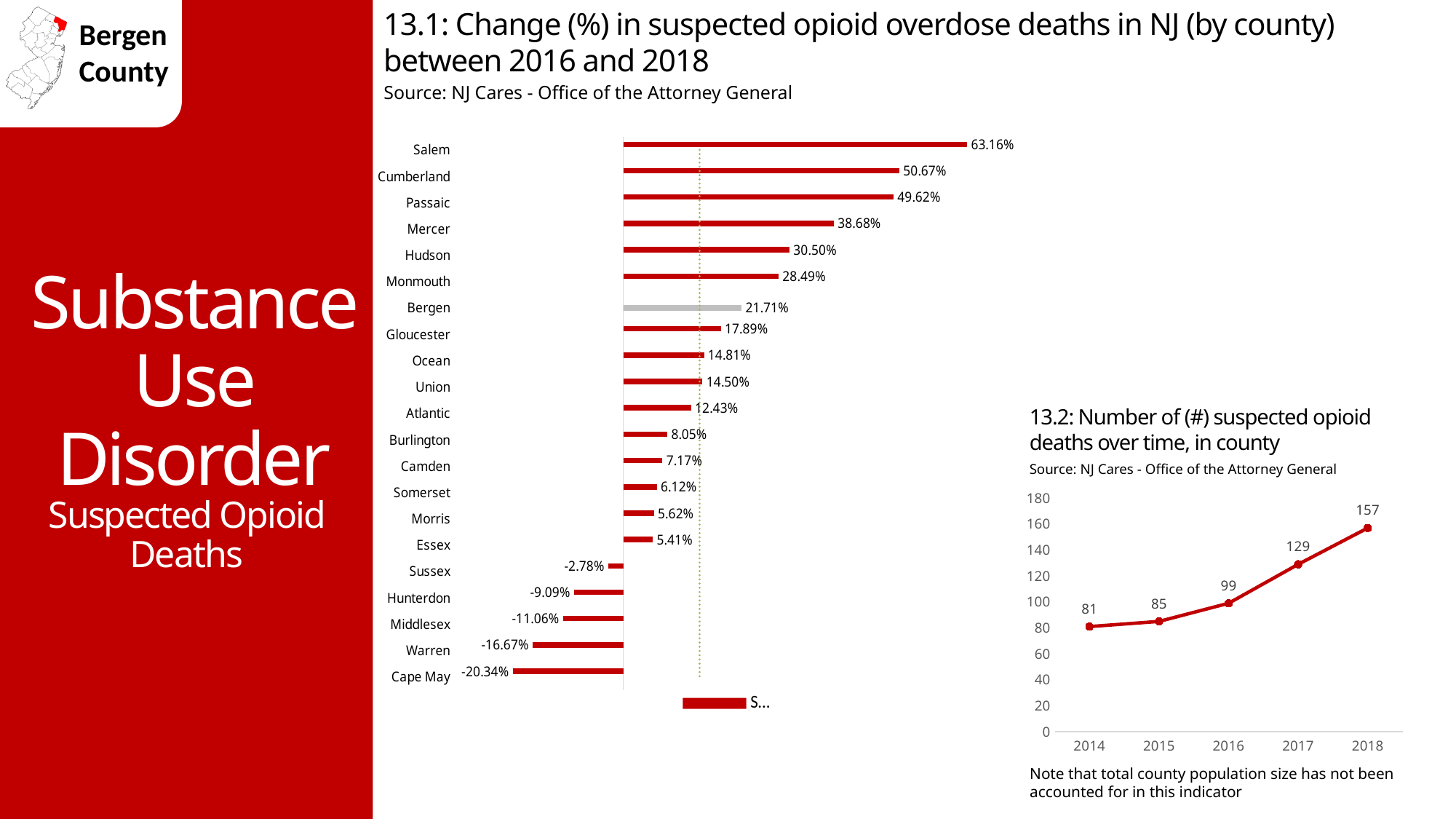
In chart 13.1, which county has the highest change (%) in suspected opioid overdose deaths? Salem What kind of chart is chart 13.1? Bar chart In chart 13.2, what is the difference between the number of suspected opioid deaths in 2018 and in 2014? 76 In chart 13.1, what is the change (%) in suspected opioid overdose deaths for Bergen? 21.71% What kind of chart is chart 13.2? Line chart In chart 13.1, which county has the lowest change (%) in suspected opioid overdose deaths? Cape May In chart 13.1, which is larger, the value for Passaic or the value for Mercer? Passaic In chart 13.1, what is the value shown for Hunterdon? -9.09% In chart 13.2, how many years are plotted? 5 In chart 13.1, how many counties are listed? 21 In chart 13.2, what is the number of suspected opioid deaths in 2017? 129 In chart 13.2, do the values rise or fall from 2014 to 2018? Rise